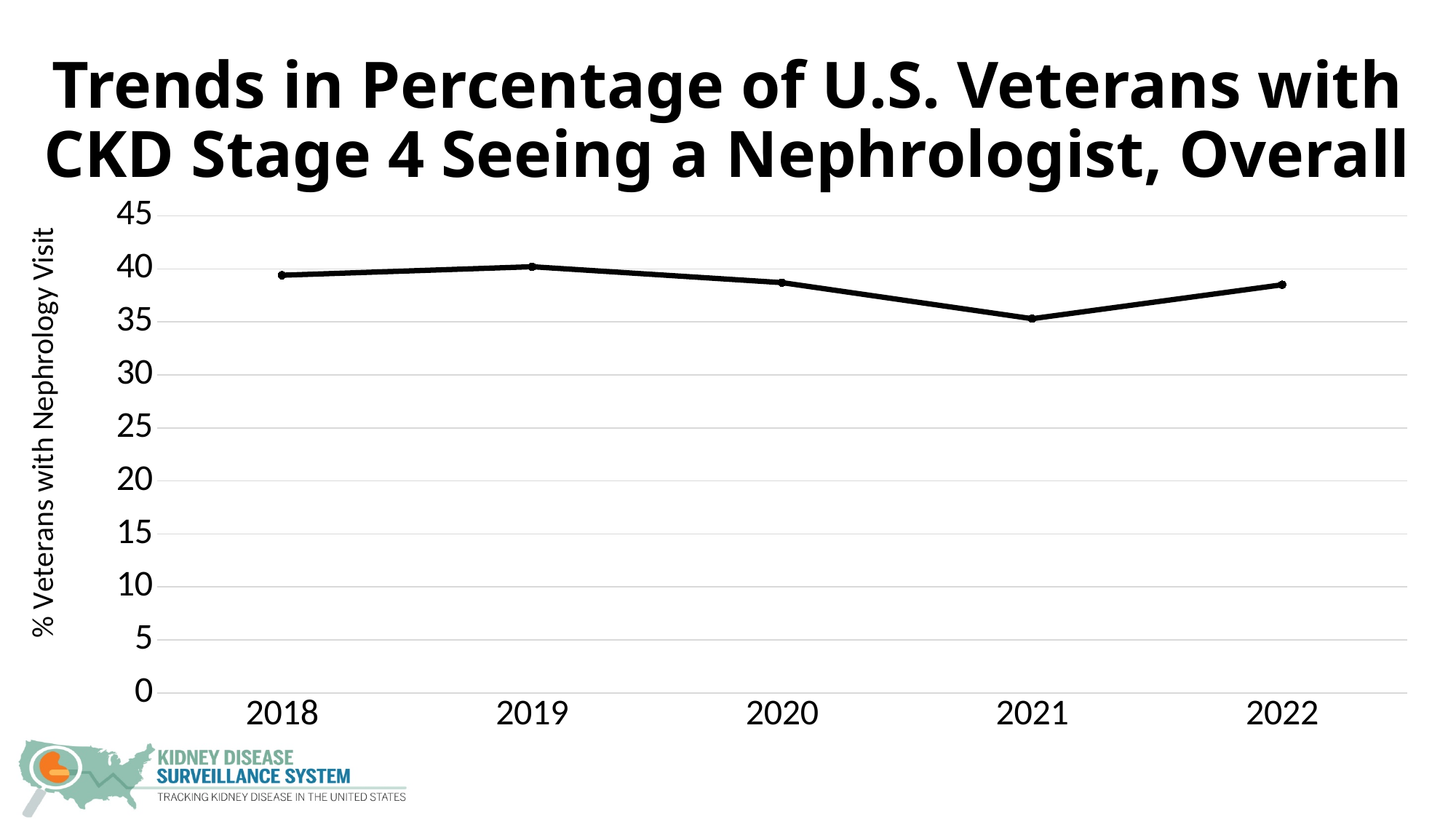
How many years are plotted on the x axis? 5 Do the values rise or fall from 2021 to 2022? rise Is the value for 2020 greater or less than 40? less What kind of chart is shown on the slide? line chart Is the value for 2021 greater or less than 40? less Which year has the larger value, 2019 or 2021? 2019 Is the value for 2019 greater or less than 35? greater Which year has the lowest percentage of veterans with a nephrology visit? 2021 Do the values rise or fall from 2019 to 2021? fall Which year has the highest percentage of veterans with a nephrology visit? 2019 What is the label on the y axis? % Veterans with Nephrology Visit